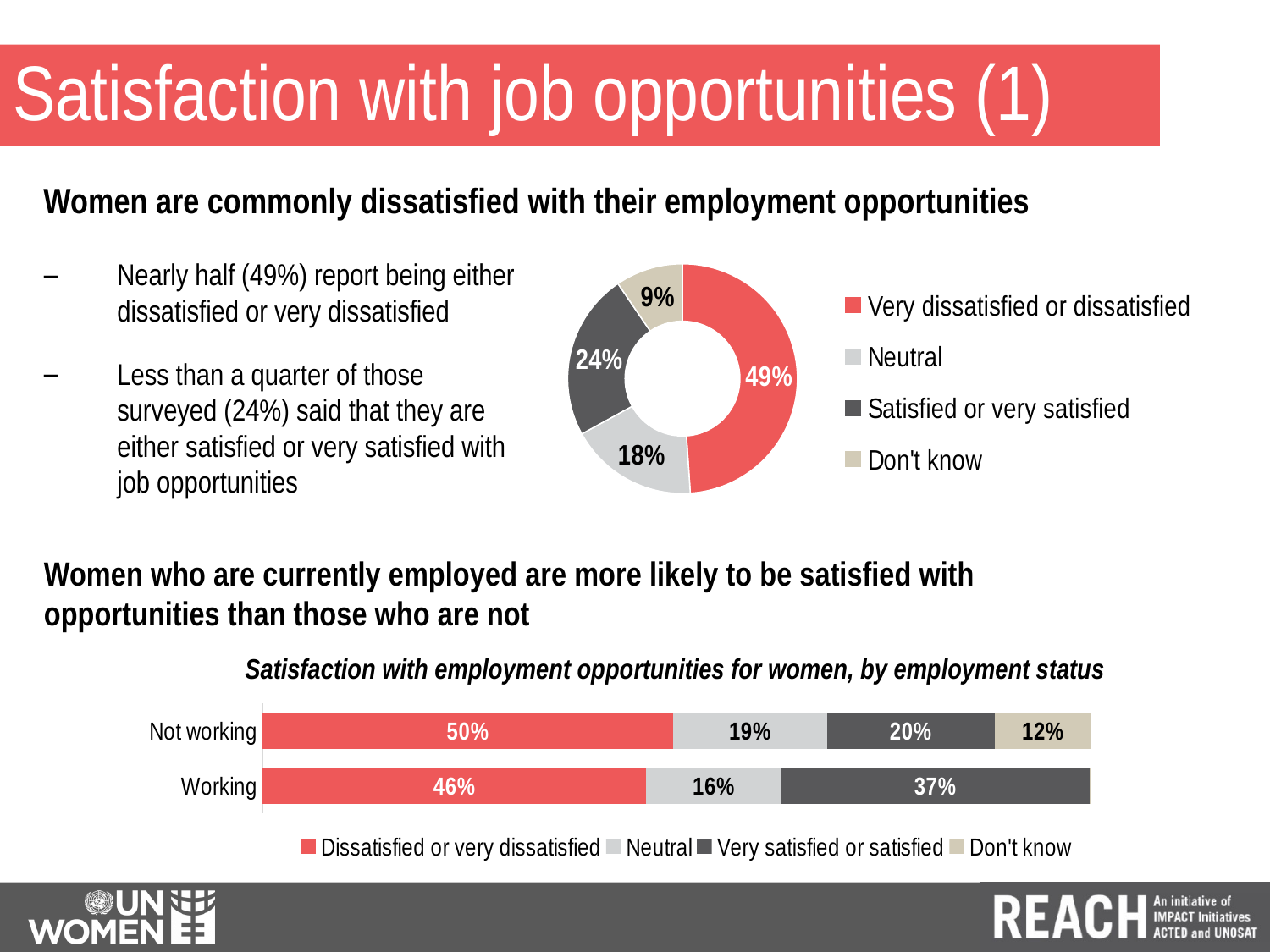
In the donut chart at the top of the slide, what share of women answered 'Don't know'? 9% In the chart titled 'Satisfaction with employment opportunities for women, by employment status', what is the difference between the 'Very satisfied or satisfied' share for Working and for Not working? 17% In the chart titled 'Satisfaction with employment opportunities for women, by employment status', what percentage of not working women answered 'Don't know'? 12% In the donut chart at the top of the slide, what share of women are very dissatisfied or dissatisfied with job opportunities? 49% How many employment status categories are shown in the chart titled 'Satisfaction with employment opportunities for women, by employment status'? 2 In the chart titled 'Satisfaction with employment opportunities for women, by employment status', what percentage of working women are very satisfied or satisfied? 37% How many categories does the legend of the donut chart at the top of the slide list? 4 In the donut chart at the top of the slide, which category has the smallest share? Don't know In the donut chart at the top of the slide, what is the difference between the 'Satisfied or very satisfied' share and the 'Neutral' share? 6% What type of chart is the chart titled 'Satisfaction with employment opportunities for women, by employment status'? Stacked bar chart In the chart titled 'Satisfaction with employment opportunities for women, by employment status', which group has the larger share of dissatisfied or very dissatisfied women, Not working or Working? Not working In the donut chart at the top of the slide, which category has the largest share? Very dissatisfied or dissatisfied